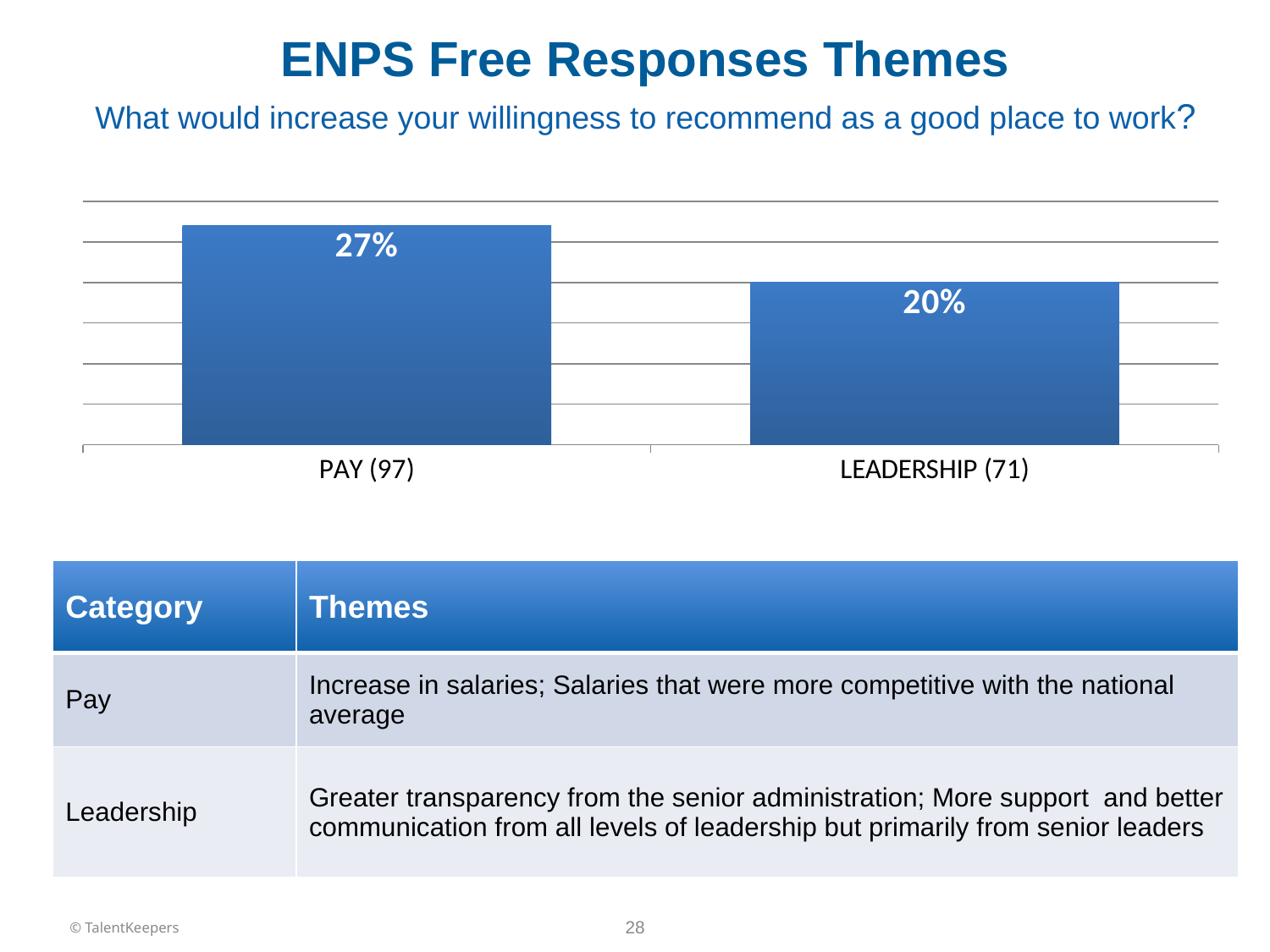
What is the value for LEADERSHIP (71)? 20% What is the value for PAY (97)? 27% What kind of chart is shown on the slide? Bar chart Which is larger, the value for PAY (97) or LEADERSHIP (71)? PAY (97) Do the values rise or fall from left to right along the x axis? Fall How many categories are shown in the chart? 2 What is the title of the slide containing the chart? ENPS Free Responses Themes Which category has the highest value? PAY (97) What colour are the bars in the chart? Blue Which category has the lowest value? LEADERSHIP (71) What is the difference between the values for PAY (97) and LEADERSHIP (71)? 7%